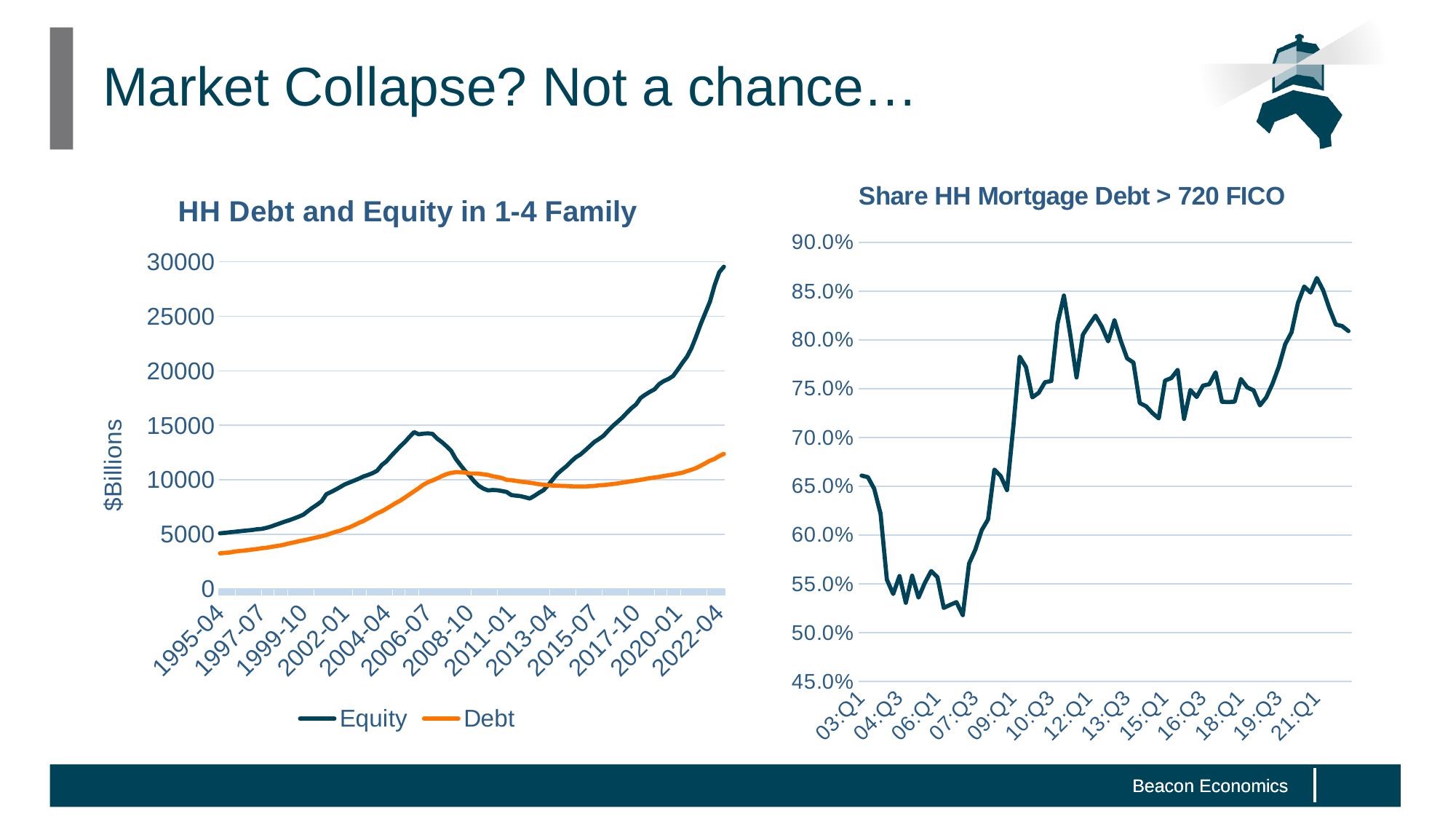
In the 'Share HH Mortgage Debt > 720 FICO' chart, is the lowest value, around 07:Q3, greater or less than 55.0%? less In the 'Share HH Mortgage Debt > 720 FICO' chart, does the share overall rise or fall from 03:Q1 to the end of the series? rise In the 'HH Debt and Equity in 1-4 Family' chart, is the Equity value at 2022-04 greater or less than 25000? greater In the 'HH Debt and Equity in 1-4 Family' chart, is the Debt value at 2022-04 greater or less than 15000? less In the 'HH Debt and Equity in 1-4 Family' chart, what is the y-axis label? $Billions In the 'HH Debt and Equity in 1-4 Family' chart, what are the two series named in the legend? Equity and Debt How many series does the legend of the 'HH Debt and Equity in 1-4 Family' chart list? 2 What kind of chart is the 'HH Debt and Equity in 1-4 Family' chart on the left? line chart In the 'HH Debt and Equity in 1-4 Family' chart, which series is larger at 2011-01, Equity or Debt? Debt In the 'HH Debt and Equity in 1-4 Family' chart, which series is larger at 2022-04, Equity or Debt? Equity What kind of chart is the 'Share HH Mortgage Debt > 720 FICO' chart on the right? line chart